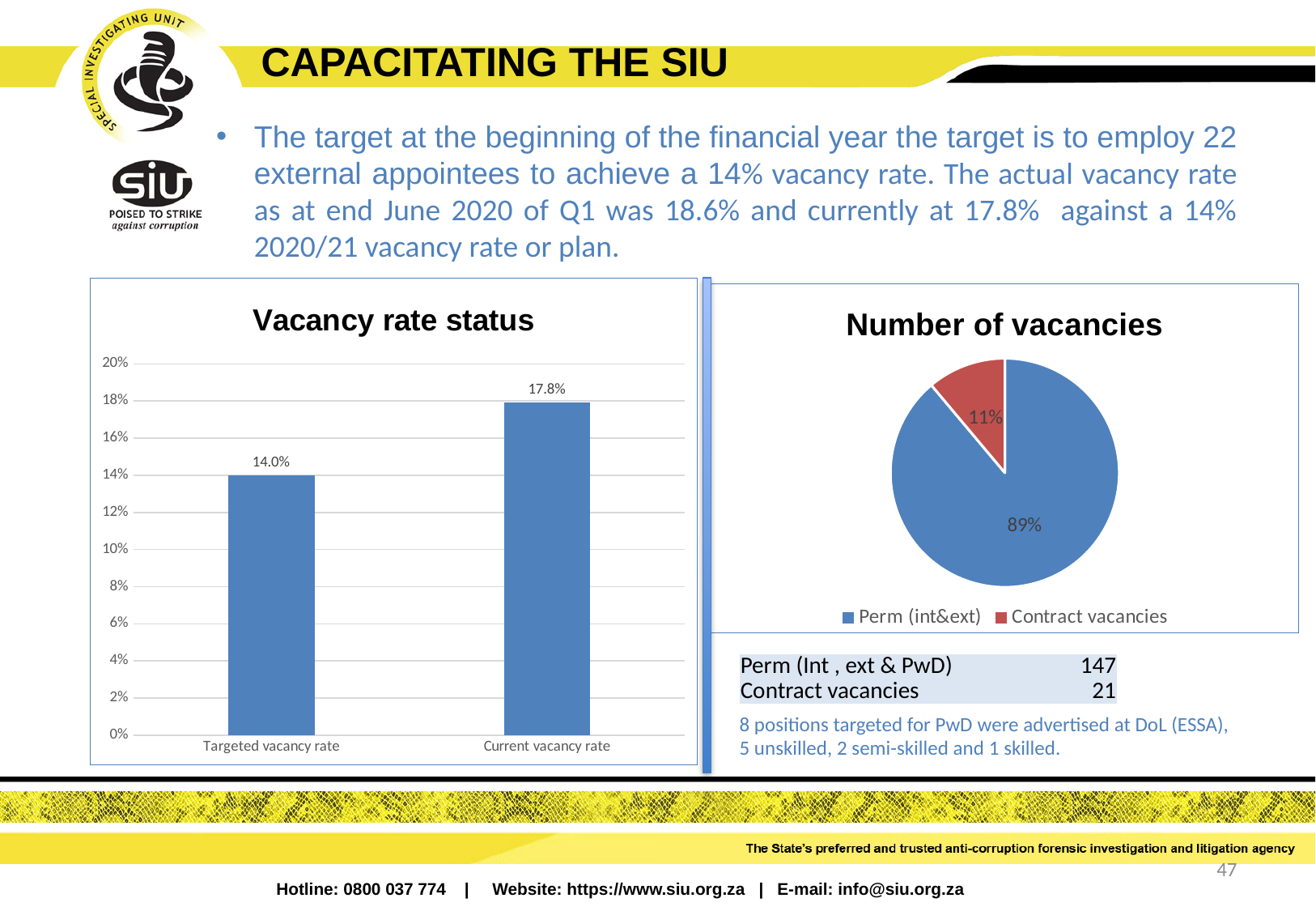
In the 'Vacancy rate status' chart, which category has the higher value? Current vacancy rate What kind of chart is 'Number of vacancies'? Pie chart In the 'Number of vacancies' chart, what share of the pie is Contract vacancies? 11% What kind of chart is 'Vacancy rate status'? Bar chart In the 'Vacancy rate status' chart, what is the value for Current vacancy rate? 17.8% In the 'Vacancy rate status' chart, is the value for Current vacancy rate greater or less than 16%? greater In the 'Vacancy rate status' chart, how many categories are shown on the x axis? 2 In the 'Vacancy rate status' chart, what is the difference between the Current vacancy rate and the Targeted vacancy rate? 3.8% In the 'Number of vacancies' chart, what share of the pie is Perm (int&ext)? 89% In the 'Number of vacancies' chart, how many entries does the legend list? 2 In the 'Vacancy rate status' chart, which category has the lower value? Targeted vacancy rate In the 'Vacancy rate status' chart, what is the value for Targeted vacancy rate? 14.0%